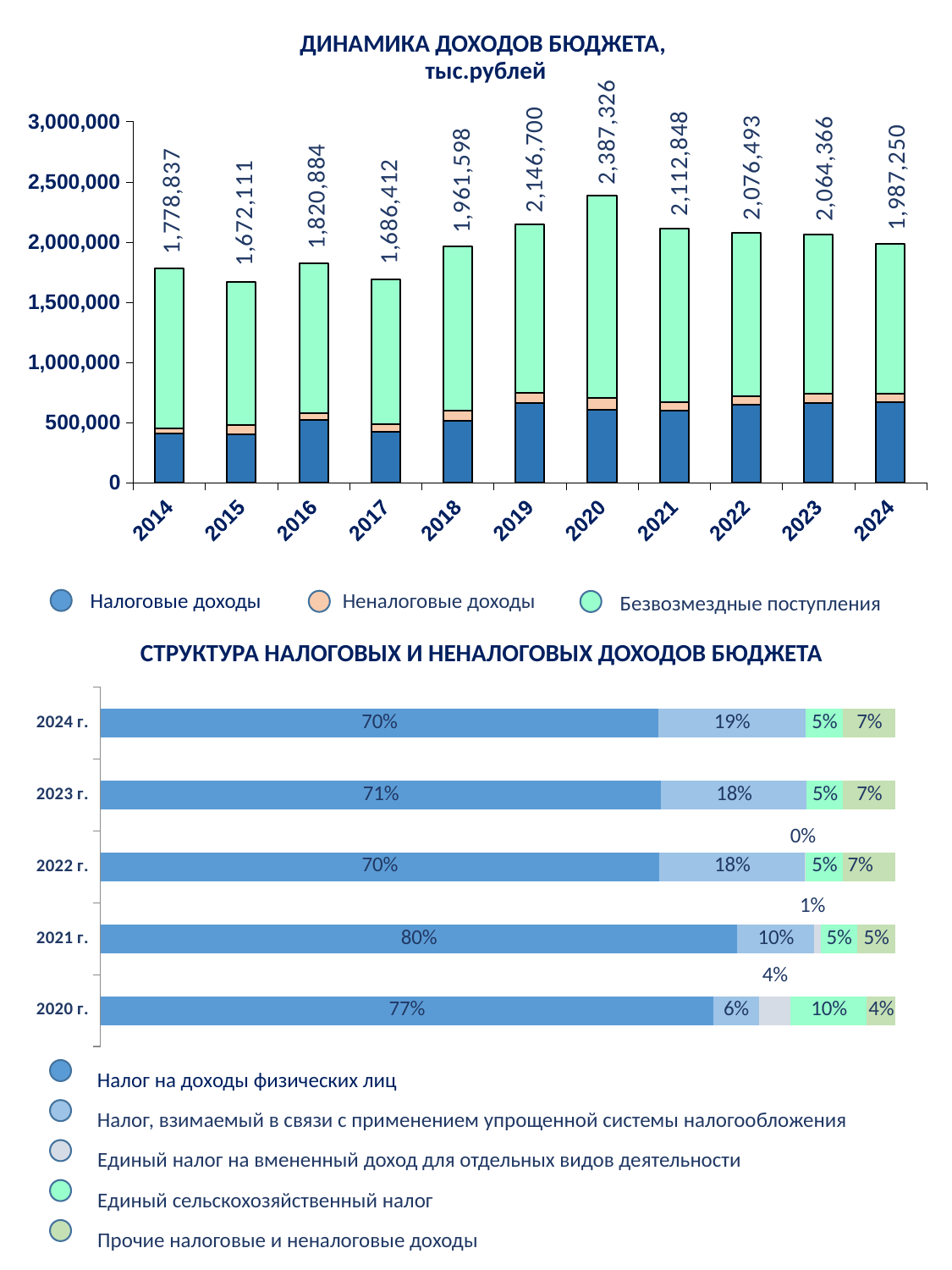
On the chart 'СТРУКТУРА НАЛОГОВЫХ И НЕНАЛОГОВЫХ ДОХОДОВ БЮДЖЕТА', what is the share of Единый сельскохозяйственный налог in 2020 г.? 10% On the chart 'ДИНАМИКА ДОХОДОВ БЮДЖЕТА, тыс.рублей', how many series does the legend list? 3 On the chart 'ДИНАМИКА ДОХОДОВ БЮДЖЕТА, тыс.рублей', what is the total budget revenue for 2024? 1,987,250 On the chart 'ДИНАМИКА ДОХОДОВ БЮДЖЕТА, тыс.рублей', which year has the lowest total revenue? 2015 On the chart 'СТРУКТУРА НАЛОГОВЫХ И НЕНАЛОГОВЫХ ДОХОДОВ БЮДЖЕТА', what is the share of Налог на доходы физических лиц in 2021 г.? 80% On the chart 'СТРУКТУРА НАЛОГОВЫХ И НЕНАЛОГОВЫХ ДОХОДОВ БЮДЖЕТА', how many series does the legend list? 5 On the chart 'ДИНАМИКА ДОХОДОВ БЮДЖЕТА, тыс.рублей', is the value of Налоговые доходы for 2019 greater or less than 500,000? greater On the chart 'ДИНАМИКА ДОХОДОВ БЮДЖЕТА, тыс.рублей', how many years are shown on the x axis? 11 What kind of chart is 'СТРУКТУРА НАЛОГОВЫХ И НЕНАЛОГОВЫХ ДОХОДОВ БЮДЖЕТА'? Stacked bar chart On the chart 'ДИНАМИКА ДОХОДОВ БЮДЖЕТА, тыс.рублей', what is the total budget revenue for 2020? 2,387,326 On the chart 'ДИНАМИКА ДОХОДОВ БЮДЖЕТА, тыс.рублей', which year has the highest total revenue? 2020 On the chart 'ДИНАМИКА ДОХОДОВ БЮДЖЕТА, тыс.рублей', what is the difference between the total revenue in 2020 and in 2019? 240,626